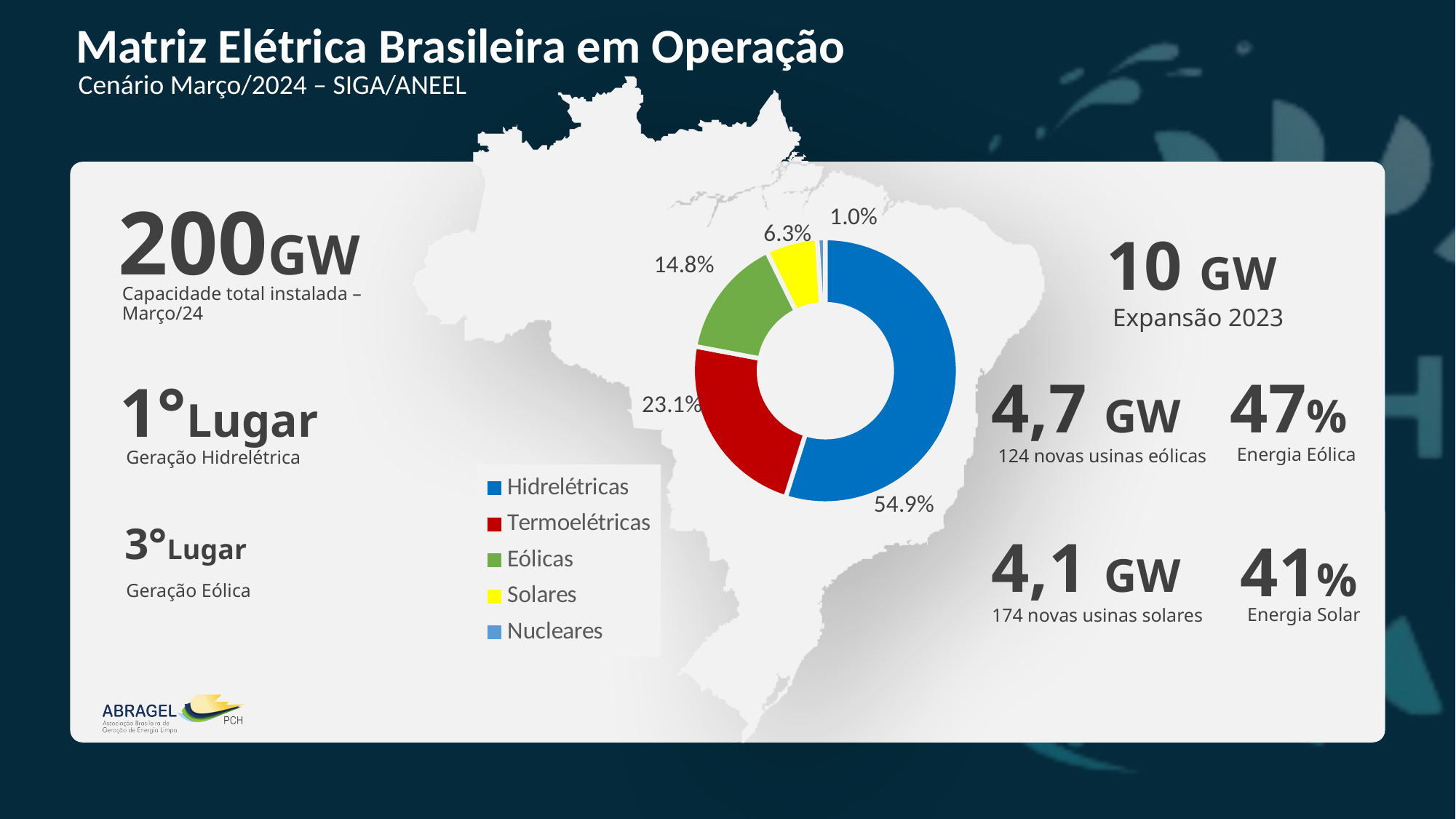
What share of the pie chart is Solares? 6.3% What share of the pie chart is Hidrelétricas? 54.9% What share of the pie chart is Termoelétricas? 23.1% What is the difference in percentage points between Hidrelétricas and Termoelétricas? 31.8 What share of the pie chart is Nucleares? 1.0% Which category has the smallest slice of the pie chart? Nucleares What kind of chart is shown on the slide? Pie chart (donut) What share of the pie chart is Eólicas? 14.8% Which category has the largest slice of the pie chart? Hidrelétricas What colour represents Termoelétricas in the pie chart? Red How many categories does the pie chart show? 5 Which is larger in the pie chart, Eólicas or Solares? Eólicas